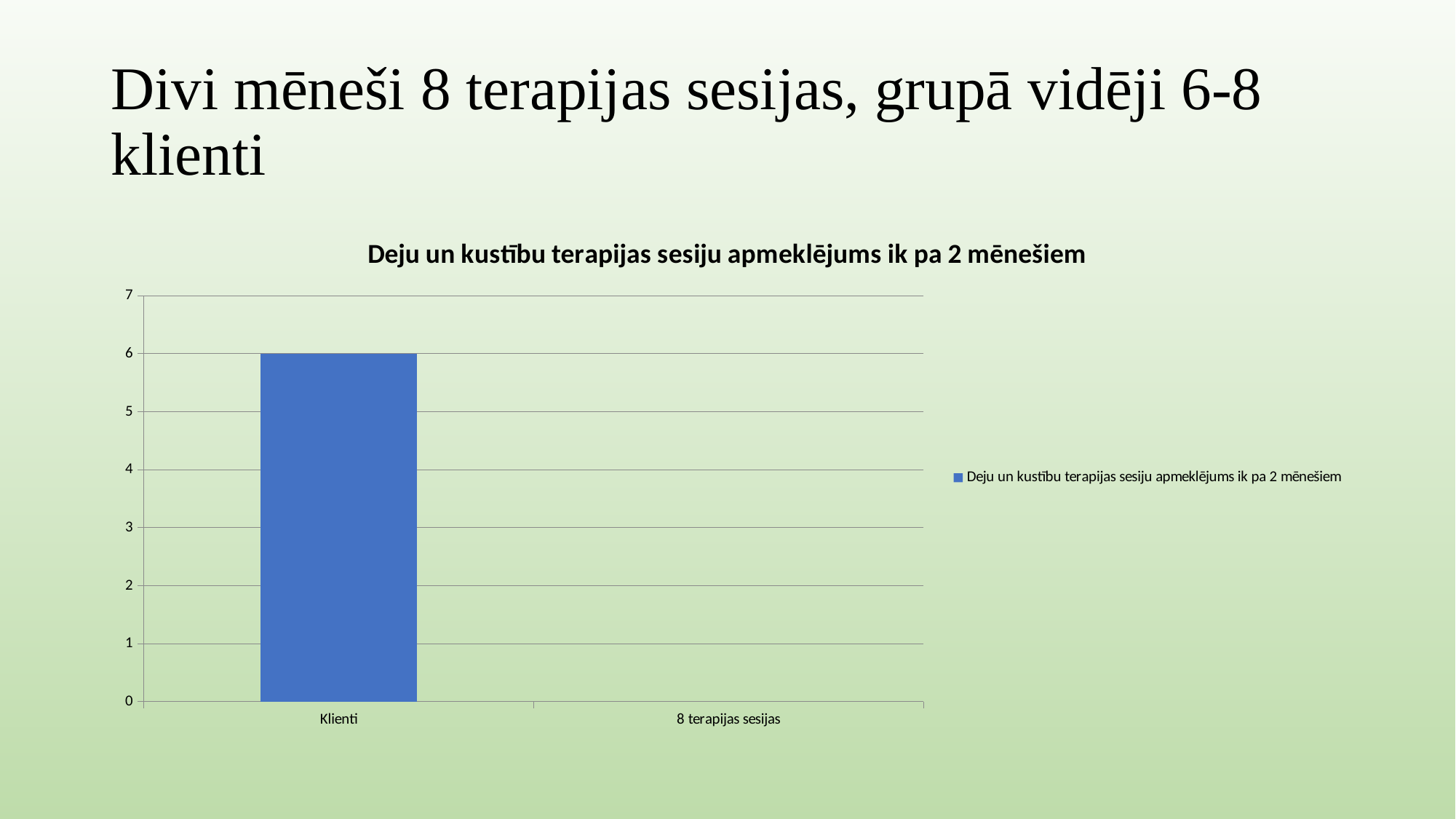
What is the title of the chart? Deju un kustību terapijas sesiju apmeklējums ik pa 2 mēnešiem Is the value for Klienti greater or less than 5? greater How many categories are shown on the x axis? 2 How many series does the legend list? 1 What is the highest value shown on the vertical axis? 7 What kind of chart is shown on the slide? bar chart Which category has the highest value? Klienti What is the value for Klienti? 6 Is the value for Klienti greater or less than 7? less Which category is shown second on the x axis? 8 terapijas sesijas